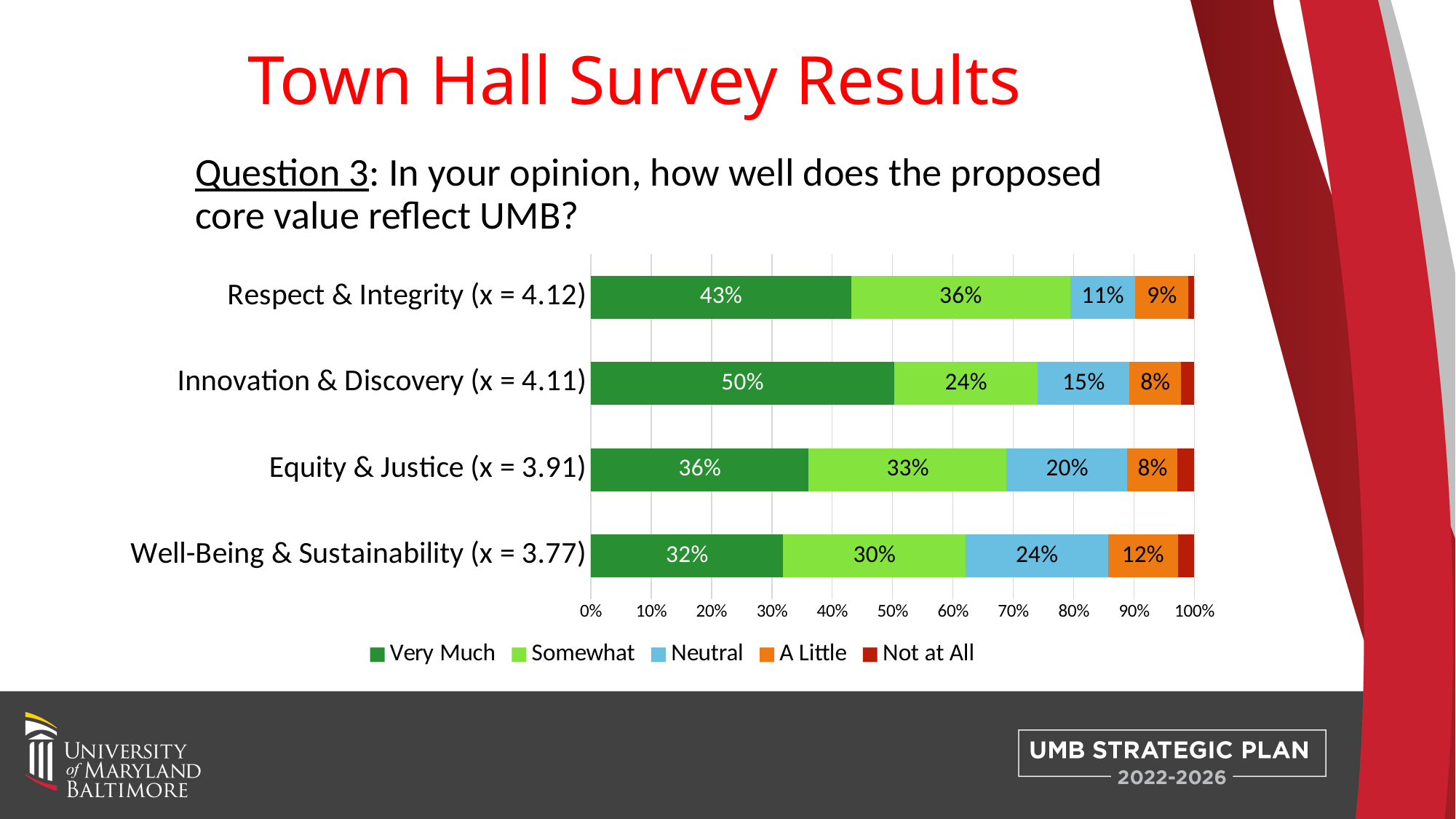
Which has a larger "Somewhat" value, Equity & Justice or Well-Being & Sustainability? Equity & Justice What percentage of respondents answered "Very Much" for Innovation & Discovery? 50% How many response categories does the legend list? 5 Which core value has the lowest "Very Much" percentage? Well-Being & Sustainability How many core values are shown in the chart? 4 How many percentage points higher is the "Very Much" value for Innovation & Discovery than for Respect & Integrity? 7 What is the difference between the "Somewhat" values for Respect & Integrity and Innovation & Discovery? 12 Which core value has the highest "Very Much" percentage? Innovation & Discovery What type of chart is shown on the slide? Stacked bar chart What is the "A Little" value for Respect & Integrity? 9% What is the "Neutral" value for Well-Being & Sustainability? 24% Which core value has the highest "Neutral" percentage? Well-Being & Sustainability